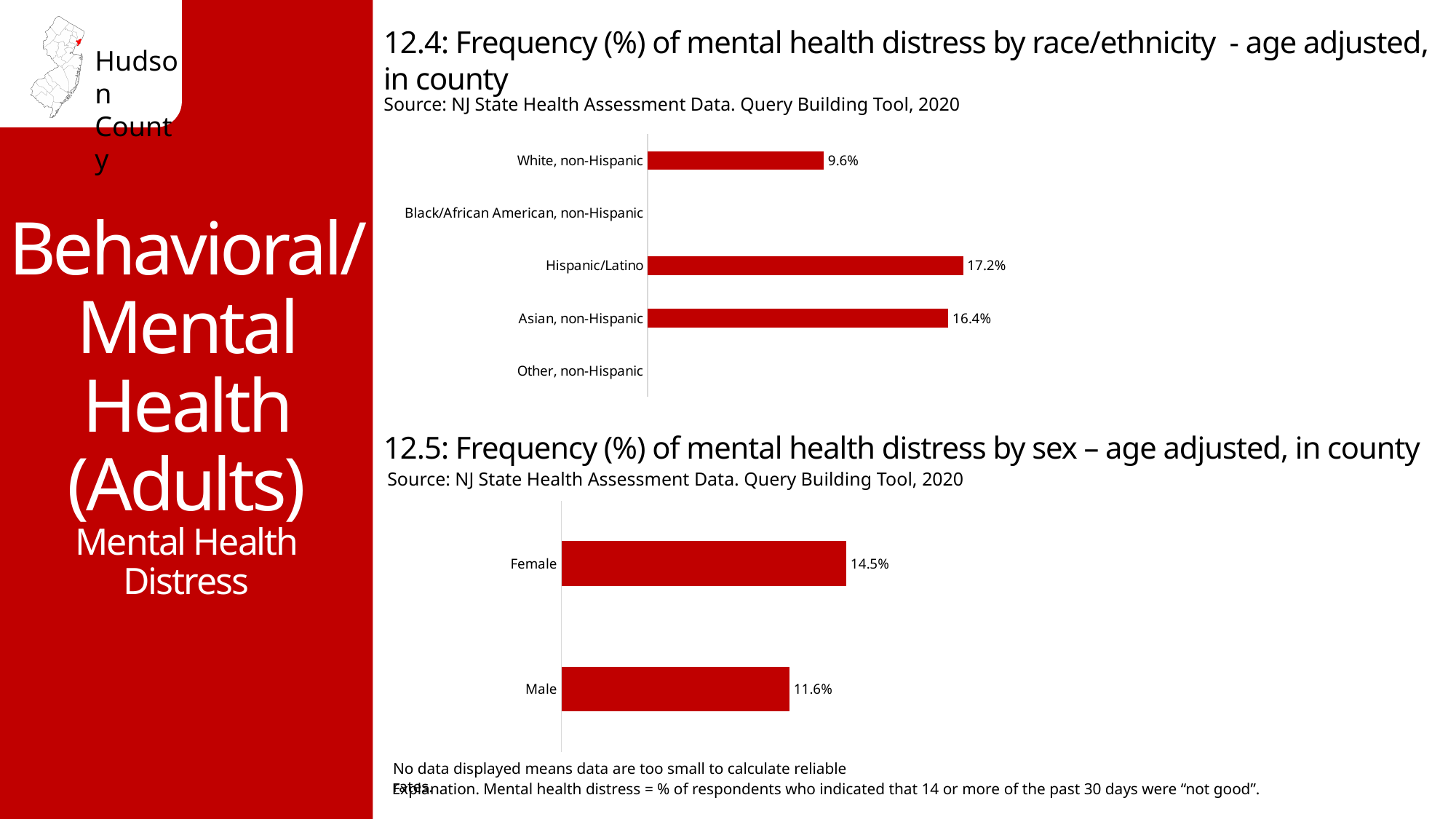
In the chart 12.5 (mental health distress by sex), what is the difference between the Female and Male values? 2.9% In the chart 12.4 (mental health distress by race/ethnicity), which categories have no bar displayed? Black/African American, non-Hispanic and Other, non-Hispanic In the chart 12.4 (mental health distress by race/ethnicity), what is the value for Hispanic/Latino? 17.2% In the chart 12.4 (mental health distress by race/ethnicity), how many race/ethnicity categories are listed on the axis? 5 What type of chart is chart 12.5 (mental health distress by sex)? Bar chart In the chart 12.5 (mental health distress by sex), what is the value for Female? 14.5% In the chart 12.5 (mental health distress by sex), what is the value for Male? 11.6% In the chart 12.4 (mental health distress by race/ethnicity), what is the value for Asian, non-Hispanic? 16.4% In the chart 12.4 (mental health distress by race/ethnicity), what is the value for White, non-Hispanic? 9.6% In the chart 12.4 (mental health distress by race/ethnicity), what is the difference between the Hispanic/Latino and White, non-Hispanic values? 7.6% In the chart 12.4 (mental health distress by race/ethnicity), which category has the highest value? Hispanic/Latino In the chart 12.5 (mental health distress by sex), which is larger, the Female or the Male value? Female